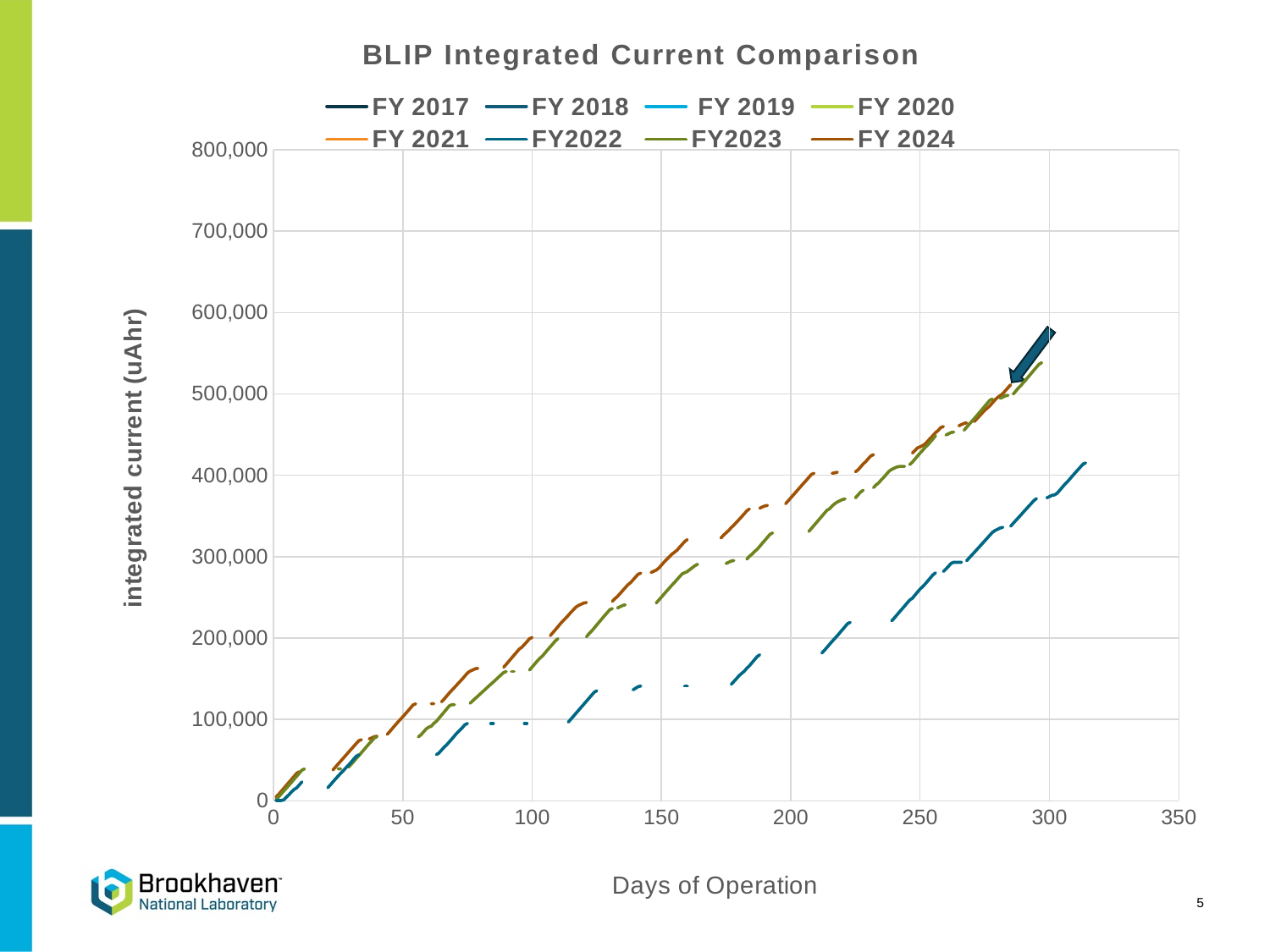
Is the FY 2024 value at 100 days of operation greater or less than 300,000? less Is the FY2022 value at 300 days of operation greater or less than 400,000? less At 250 days of operation, which series has the higher integrated current, FY2023 or FY2022? FY2023 Do the plotted lines rise or fall as Days of Operation increases? rise What is the highest value shown on the y axis? 800,000 How many series does the legend of the BLIP Integrated Current Comparison chart list? 8 Is the FY 2024 value at 150 days of operation greater or less than 200,000? greater What kind of chart is shown on the slide? line chart What is the title of the chart? BLIP Integrated Current Comparison What is the label of the y axis? integrated current (uAhr)